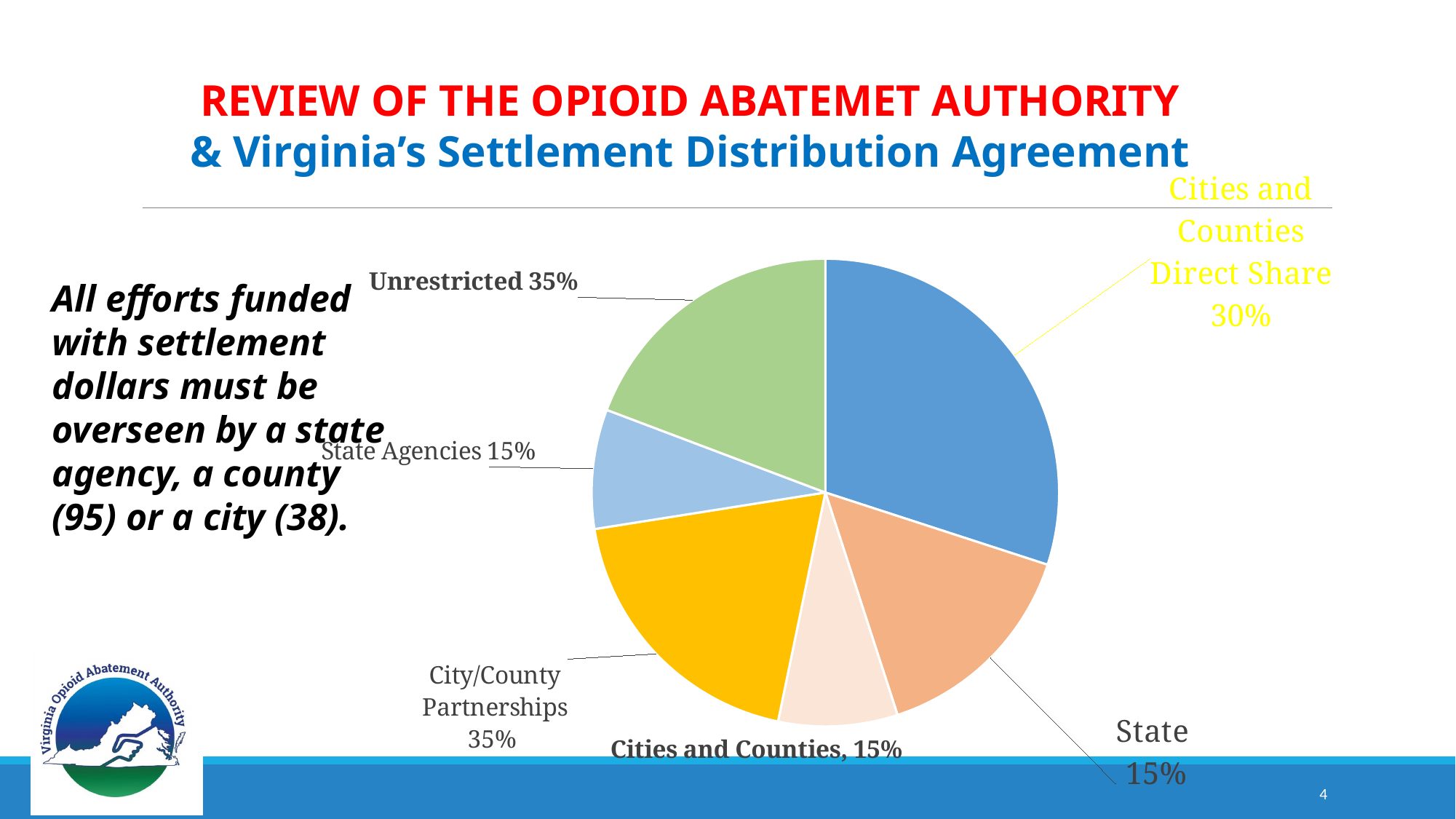
What is the difference between the labelled percentages for Cities and Counties Direct Share and State? 15% What is the difference between the labelled percentages for Unrestricted and State Agencies? 20% What percentage is labelled for Cities and Counties? 15% What colour is the Cities and Counties Direct Share slice? blue What percentage is labelled for Unrestricted? 35% What percentage is labelled for City/County Partnerships? 35% How many slices does the pie chart have? 6 Which is larger, the Cities and Counties Direct Share slice or the State slice? Cities and Counties Direct Share What percentage is labelled for Cities and Counties Direct Share? 30% What percentage is labelled for the State slice? 15% What kind of chart is shown on the slide? pie chart What percentage is labelled for State Agencies? 15%